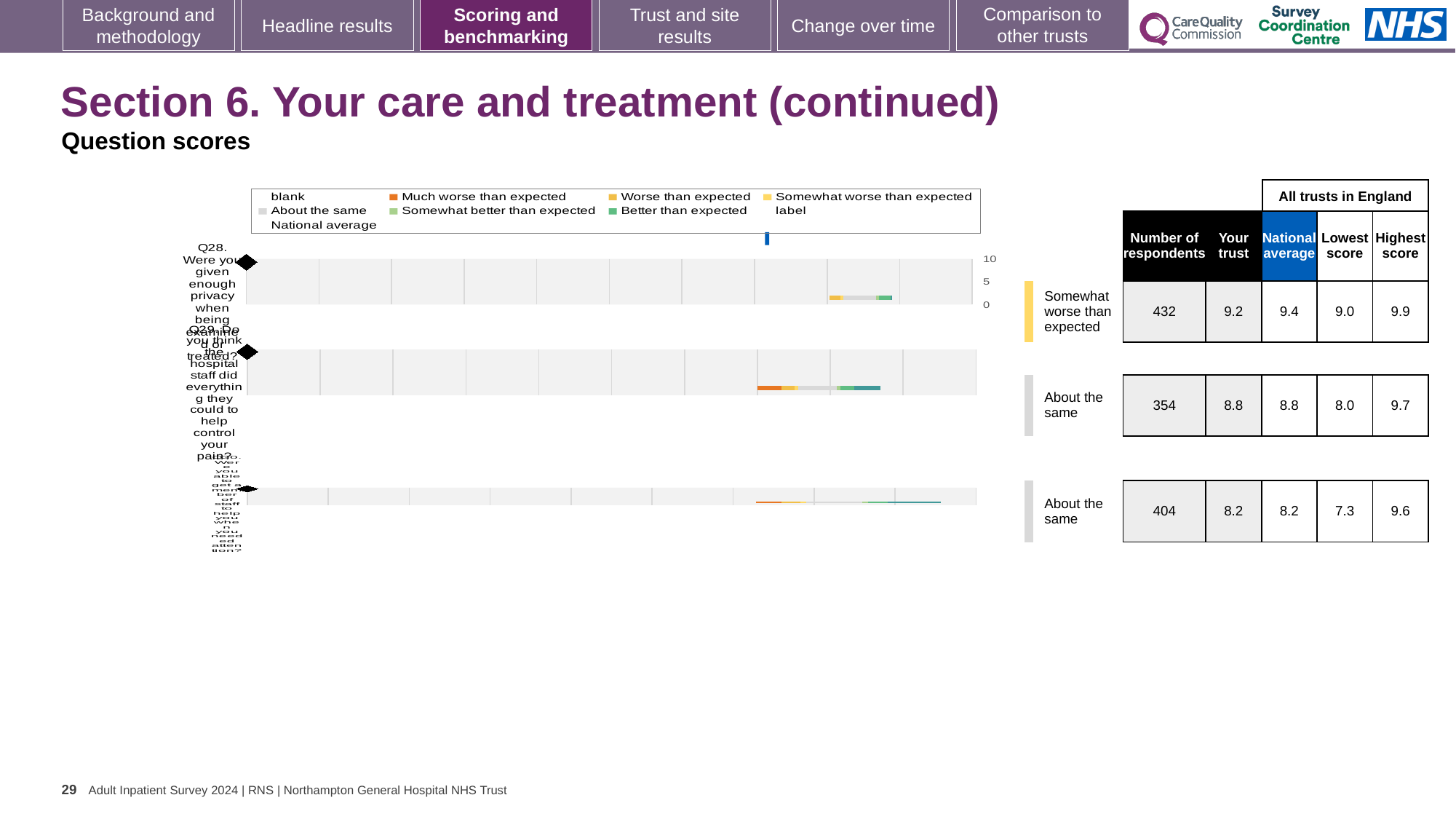
What benchmark category is shown for Q28? Somewhat worse than expected What colour represents 'Much worse than expected' in the legend? Orange For Q28, which is larger: the 'Your trust' score or the national average? National average What kind of chart is used to show the question scores on this slide? bar chart What is the national average score for Q29 (hospital staff helping control pain)? 8.8 What is the difference between the highest and lowest scores for Q28? 0.9 What is the 'Your trust' score for Q28 (privacy when being examined or treated)? 9.2 How many survey questions are plotted in the chart? 3 How many respondents answered Q30? 404 What is the highest score across all trusts in England for Q28? 9.9 Which question has the highest 'Your trust' score? Q28 What is the lowest score across all trusts in England for Q30? 7.3